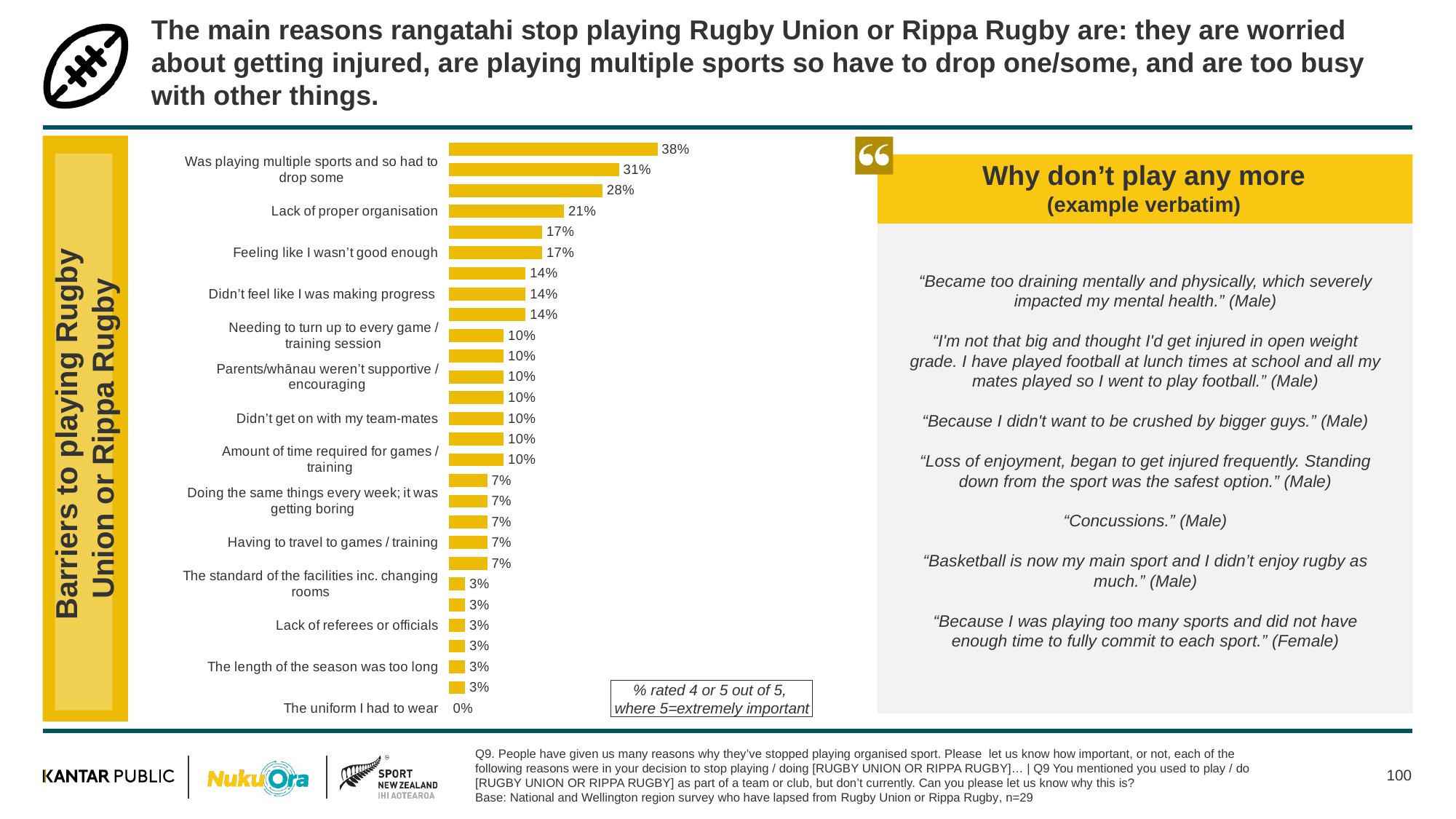
What value is shown for 'Was playing multiple sports and so had to drop some'? 31% What kind of chart is used to show the barriers to playing Rugby Union or Rippa Rugby? Bar chart What value is shown for 'Feeling like I wasn't good enough'? 17% According to the note on the chart, what do the percentages represent? % rated 4 or 5 out of 5, where 5=extremely important What percentage is shown for 'Lack of referees or officials'? 3% Which has a higher value: 'Didn't feel like I was making progress' or 'Having to travel to games / training'? Didn't feel like I was making progress What is the highest value printed on the chart? 38% What is the title of the panel to the right of the chart? Why don't play any more (example verbatim) What percentage is shown for 'The uniform I had to wear'? 0% Which labelled barrier has the lowest value on the chart? The uniform I had to wear What is the difference between the values for 'Lack of proper organisation' and 'Feeling like I wasn't good enough'? 4 percentage points What percentage is shown for 'Lack of proper organisation'? 21%